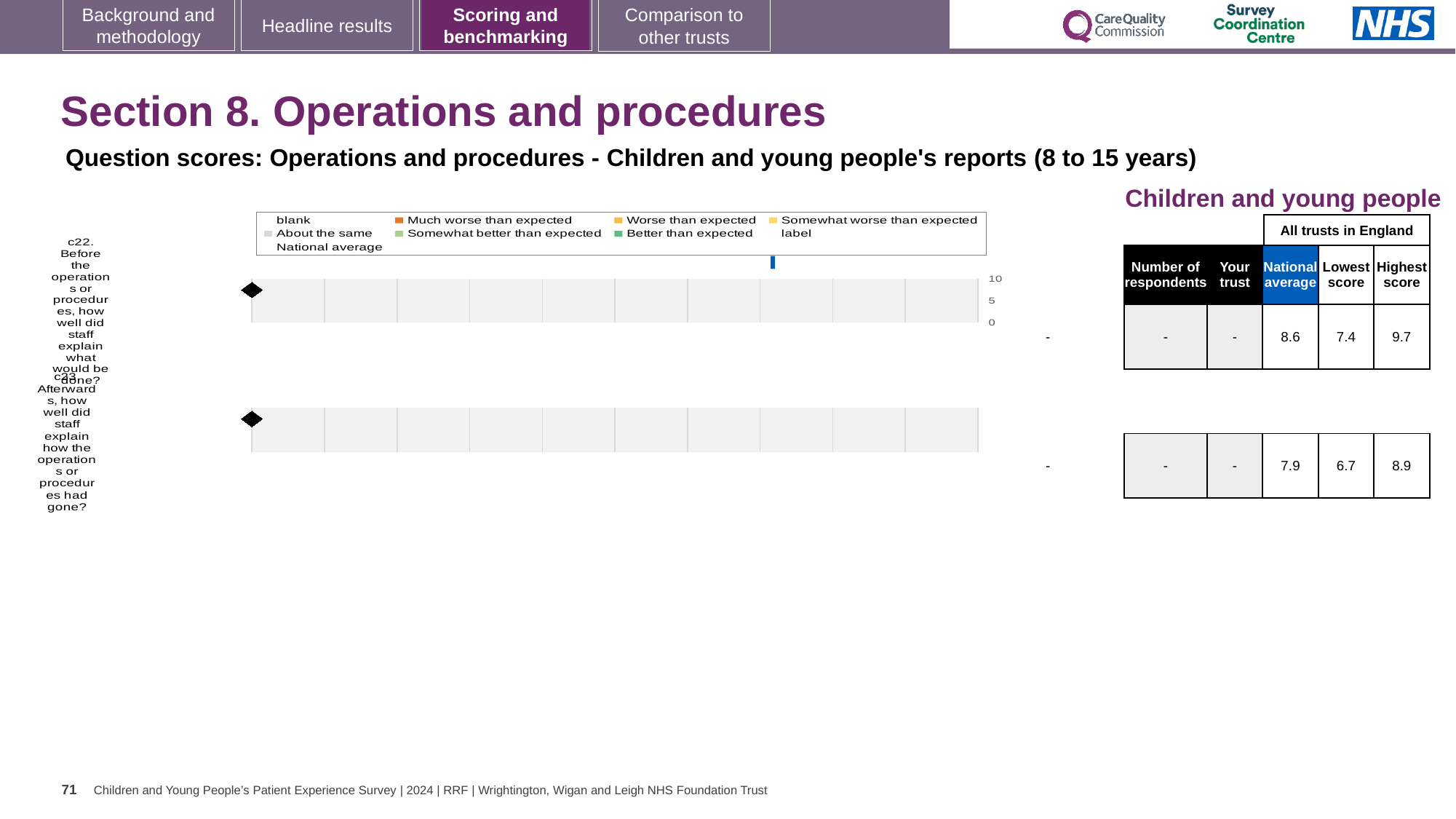
What value is shown for 'Your trust' for c22? - What is the national average score for c23 in the table? 7.9 Which question label appears first (at the top) on the chart? c22. Before the operations or procedures, how well did staff explain what would be done? How many questions (categories) are plotted on the chart? 2 What is the highest score across all trusts in England for c23? 8.9 What is the highest value shown on the chart's numeric axis? 10 Is the national average for c23 greater or less than 5? greater What is the difference between the highest and lowest scores for c22? 2.3 Which question has the higher national average, c22 or c23? c22 What kind of chart is shown on the slide? bar chart What is the national average score for c22 in the table? 8.6 What is the lowest score across all trusts in England for c22? 7.4